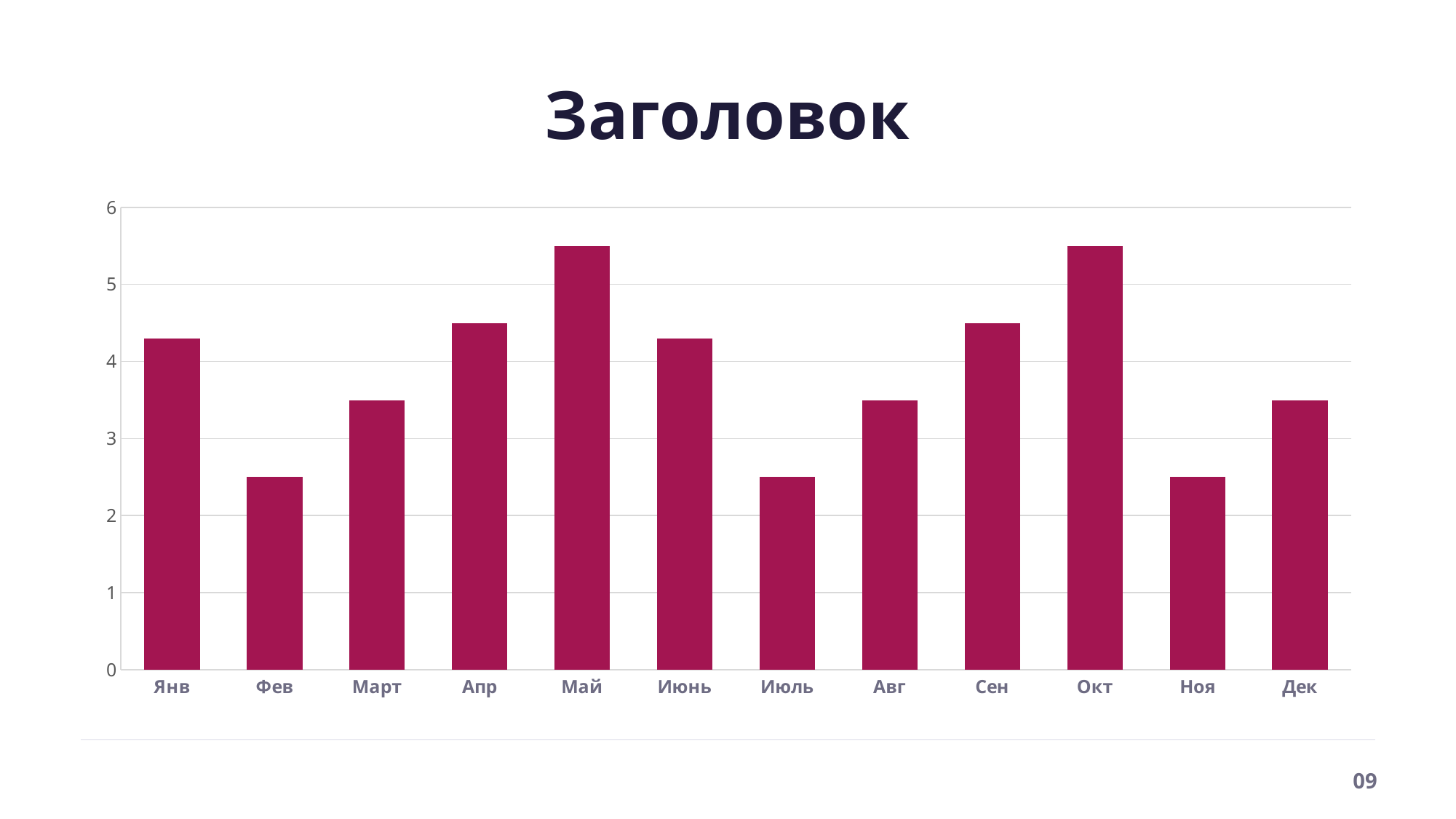
Is the value for Ноя greater or less than 3? less Which is larger, the value for Июль or the value for Сен? Сен What kind of chart is shown on the slide? bar chart How many categories are shown on the x axis of the chart? 12 Is the value for Окт greater or less than 5? greater Is the value for Дек greater or less than 4? less What is the highest tick value shown on the vertical axis? 6 What is the title of the slide with the chart? Заголовок Which is larger, the value for Май or the value for Фев? Май